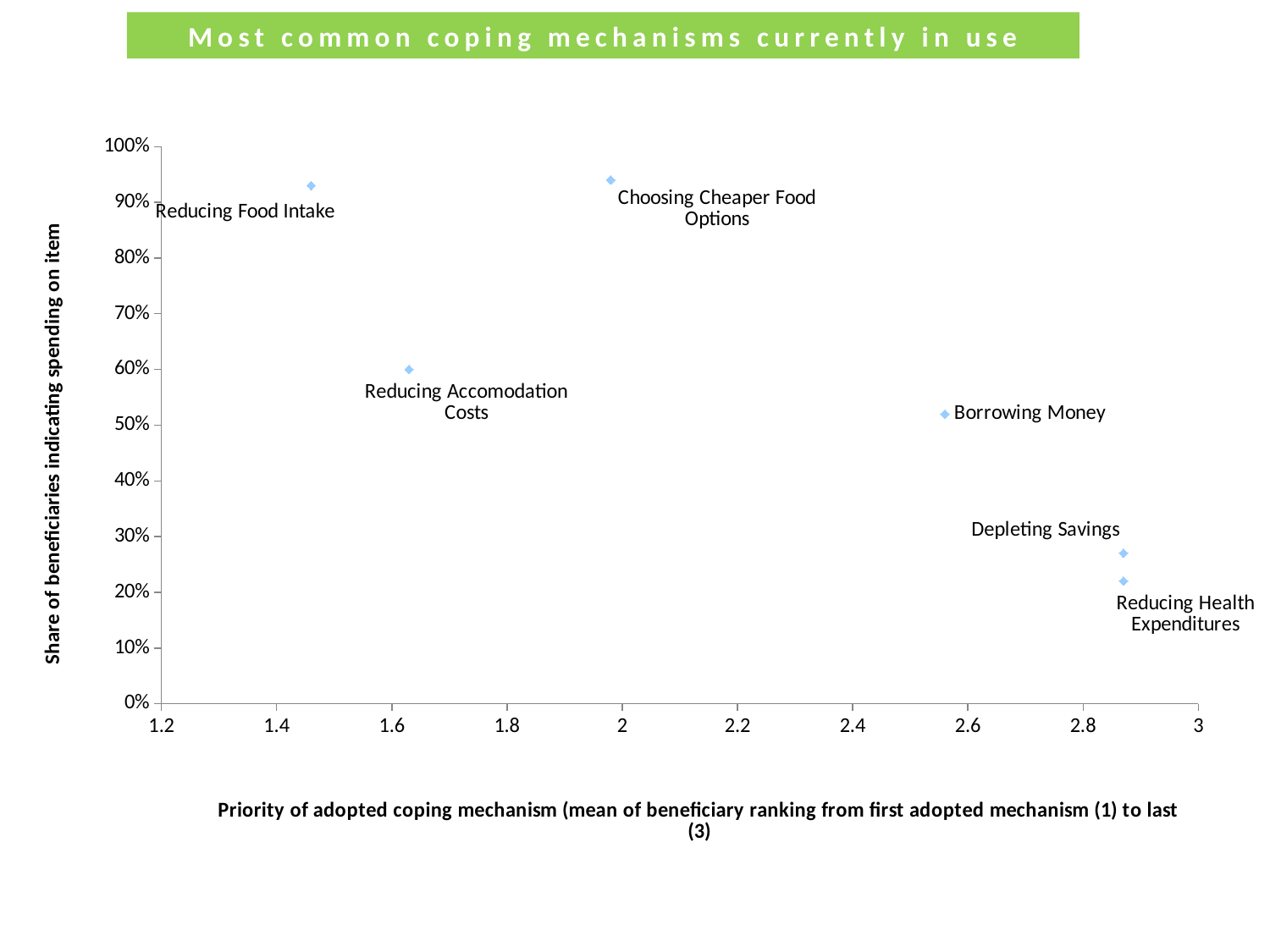
Which has a higher share of beneficiaries: Depleting Savings or Reducing Food Intake? Reducing Food Intake Is the share of beneficiaries for Borrowing Money greater or less than 60%? less What is the label of the vertical axis? Share of beneficiaries indicating spending on item How many coping mechanisms are plotted on the chart? 6 What is the title of the chart? Most common coping mechanisms currently in use Is the share of beneficiaries for Choosing Cheaper Food Options greater or less than 80%? greater Is the share of beneficiaries for Reducing Food Intake greater or less than 90%? greater Which has a higher share of beneficiaries: Reducing Accomodation Costs or Borrowing Money? Reducing Accomodation Costs What kind of chart is shown on the slide? Scatter chart Which coping mechanism has the lowest share of beneficiaries indicating spending on the item? Reducing Health Expenditures